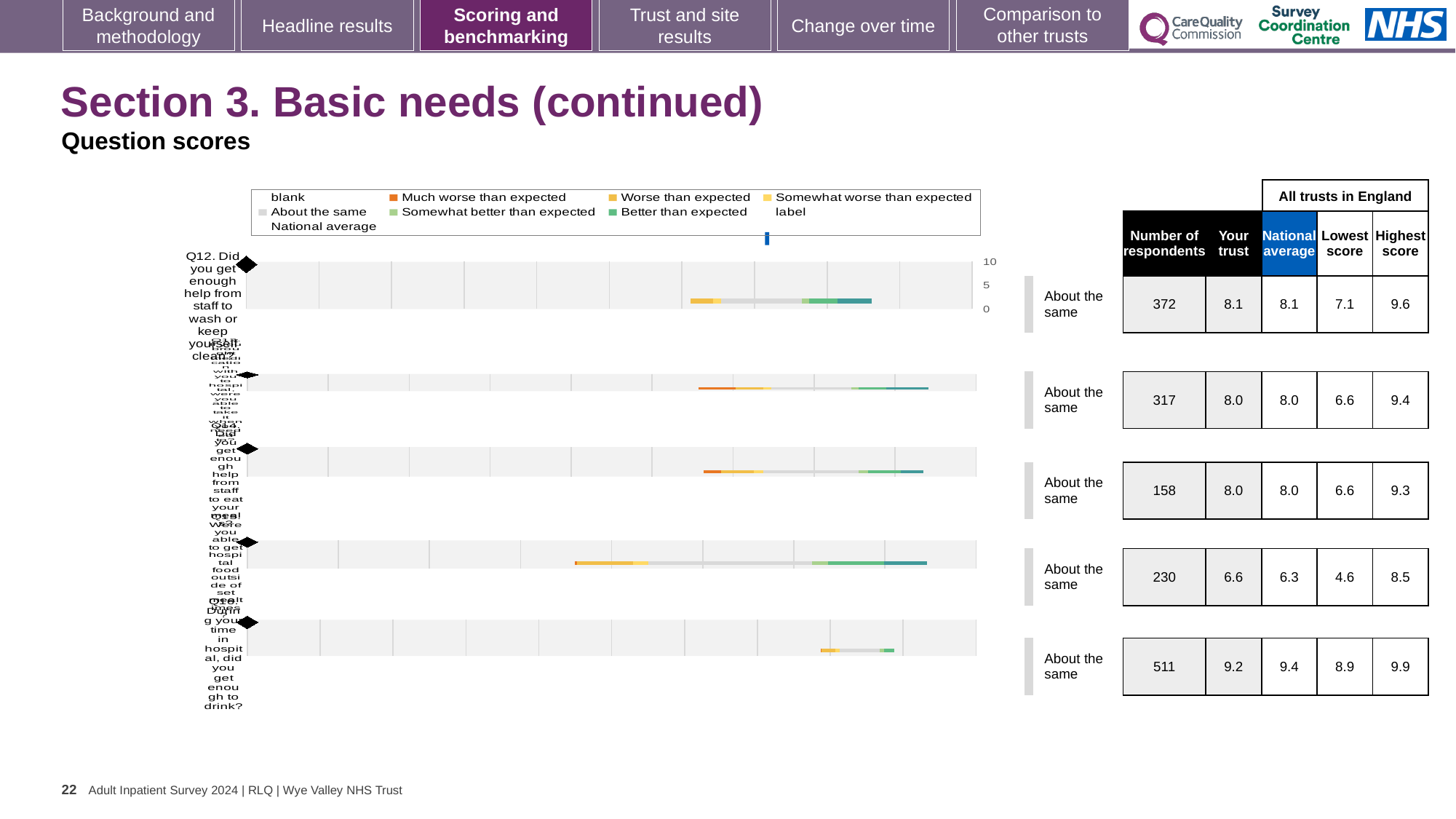
For Q12, what is the difference between the highest score and the lowest score across all trusts in England? 2.5 What benchmark category is shown for Q12 (Did you get enough help from staff to wash or keep yourself clean?)? About the same Is the 'Your trust' marker for Q12 greater or less than 5 on the axis? greater For the fourth row (230 respondents), which is larger: the 'Your trust' score or the national average? Your trust (6.6) What kind of chart is used to show the question scores on this slide? bar chart Which row has the lowest 'Your trust' score? the fourth row (230 respondents), 6.6 What is the 'Your trust' score for Q12 (Did you get enough help from staff to wash or keep yourself clean?)? 8.1 How many question rows are plotted in the chart? 5 What is the national average for the bottom row of the chart (511 respondents)? 9.4 What is the 'Your trust' score for the bottom row of the chart (511 respondents)? 9.2 Which row has the highest 'Your trust' score? the bottom row (511 respondents), 9.2 How many respondents answered Q12 (Did you get enough help from staff to wash or keep yourself clean?)? 372